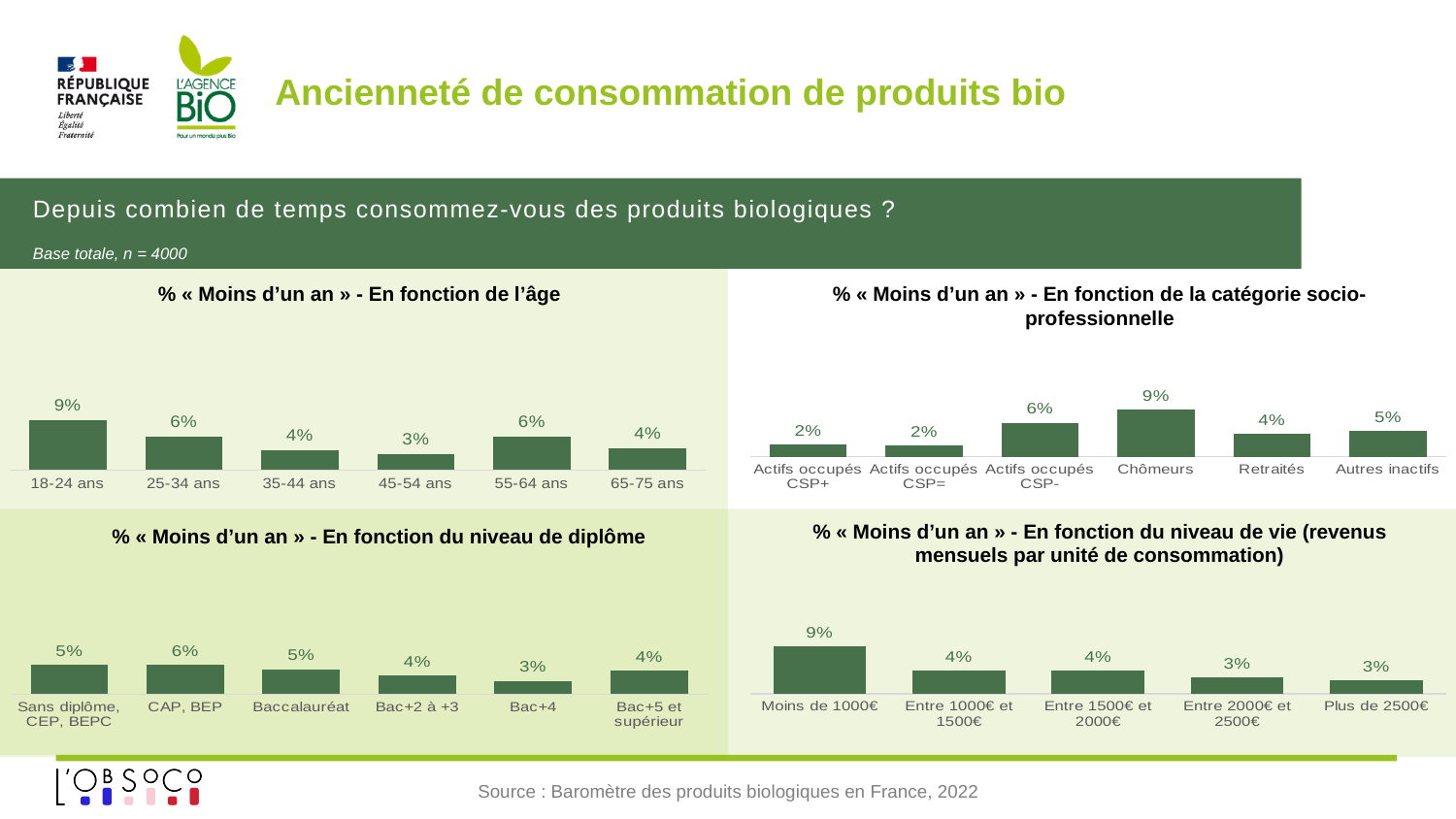
What type of chart is the top-left chart (En fonction de l'âge)? Bar chart In the top-left chart (En fonction de l'âge), what is the value for 18-24 ans? 9% In the bottom-right chart (En fonction du niveau de vie), how many income categories are shown? 5 In the top-left chart (En fonction de l'âge), how many age categories are shown? 6 In the top-left chart (En fonction de l'âge), which age group has the lowest value? 45-54 ans In the bottom-right chart (En fonction du niveau de vie), what is the value for Moins de 1000€? 9% In the bottom-right chart (En fonction du niveau de vie), which is larger: Moins de 1000€ or Plus de 2500€? Moins de 1000€ In the bottom-left chart (En fonction du niveau de diplôme), which category has the lowest value? Bac+4 In the top-right chart (En fonction de la catégorie socio-professionnelle), which category has the highest value? Chômeurs In the bottom-left chart (En fonction du niveau de diplôme), what is the value for CAP, BEP? 6% In the top-right chart (En fonction de la catégorie socio-professionnelle), what is the value for Retraités? 4% In the top-right chart (En fonction de la catégorie socio-professionnelle), what is the difference between Chômeurs and Actifs occupés CSP+? 7 percentage points